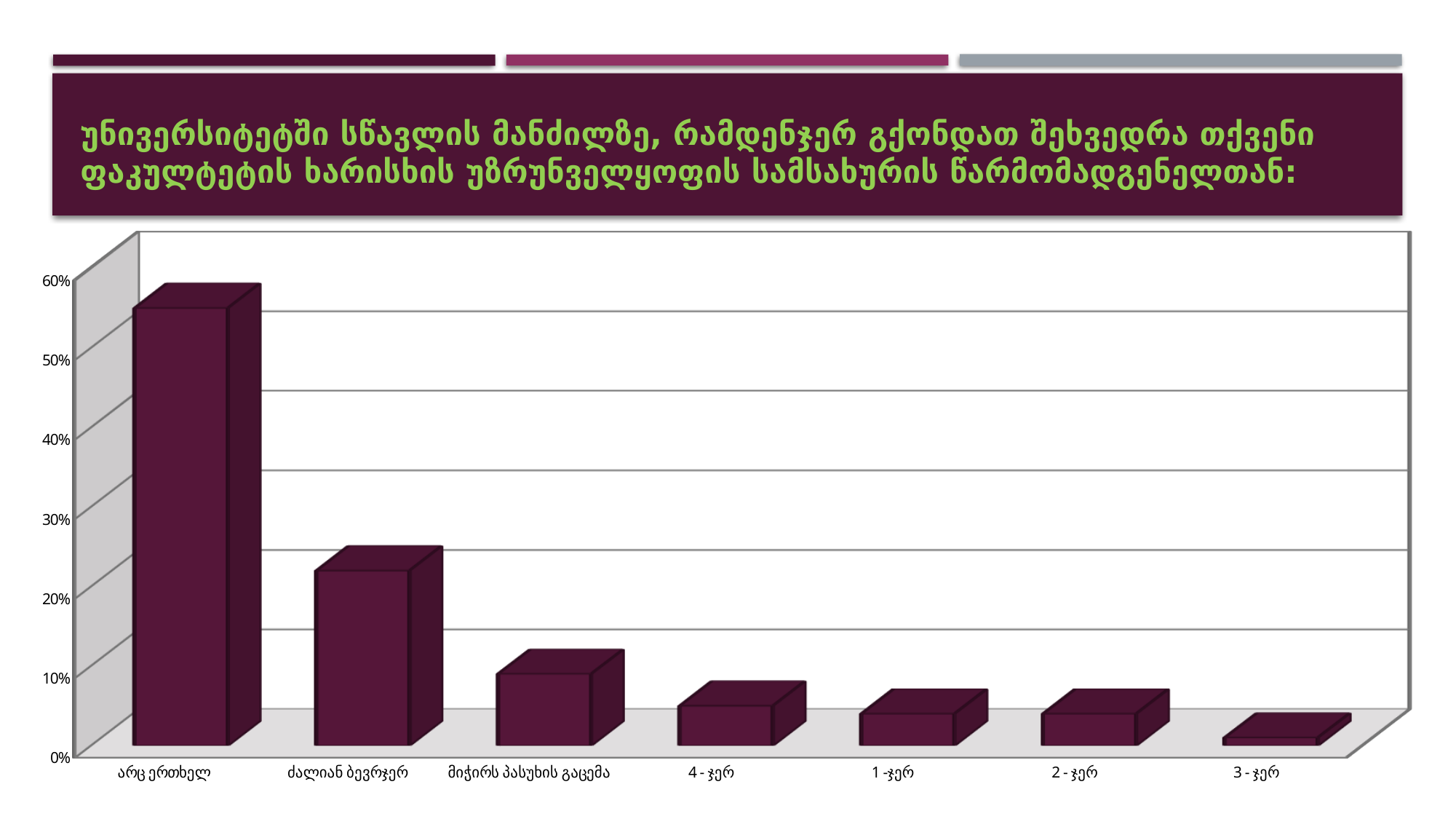
Which category has the highest value in the chart? არც ერთხელ What colour are the bars in the chart? dark purple Is the value for ძალიან ბევრჯერ greater or less than 20%? greater What kind of chart is shown on the slide? bar chart Is the value for ძალიან ბევრჯერ greater or less than 30%? less Which is larger, the value for ძალიან ბევრჯერ or the value for მიჭირს პასუხის გაცემა? ძალიან ბევრჯერ How many categories are shown on the x axis of the chart? 7 Which category has the lowest value in the chart? 3 - ჯერ Which is larger, the value for 4 - ჯერ or the value for 3 - ჯერ? 4 - ჯერ What is the highest value shown on the vertical axis of the chart? 60% Is the value for 4 - ჯერ greater or less than 10%? less